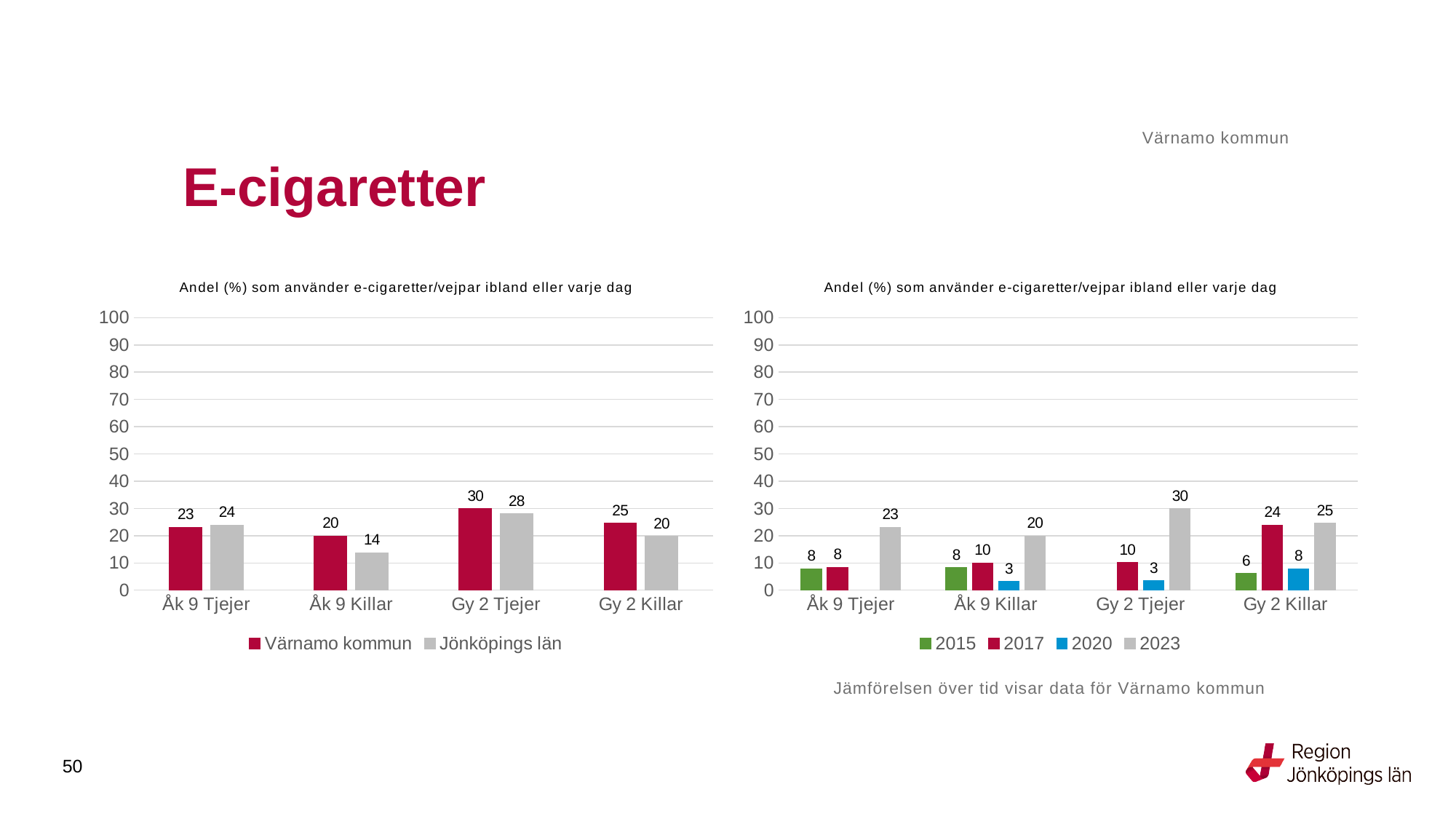
In the right chart, what is the value for 2020 for Åk 9 Killar? 3 In the right chart, how many series does the legend list? 4 In the left chart, what is the difference between Värnamo kommun and Jönköpings län for Gy 2 Killar? 5 How many categories are shown on the x axis of the left chart? 4 In the right chart, what is the difference between the 2023 and 2017 values for Åk 9 Tjejer? 15 In the right chart, what is the value for 2023 for Gy 2 Tjejer? 30 What kind of chart is the right chart? Bar chart In the left chart, what is the value for Jönköpings län for Åk 9 Killar? 14 In the left chart, which category has the highest value for Värnamo kommun? Gy 2 Tjejer In the left chart, which category has the lowest value for Jönköpings län? Åk 9 Killar In the left chart, what is the value for Värnamo kommun for Gy 2 Tjejer? 30 In the left chart, which is larger for Åk 9 Tjejer: Värnamo kommun or Jönköpings län? Jönköpings län